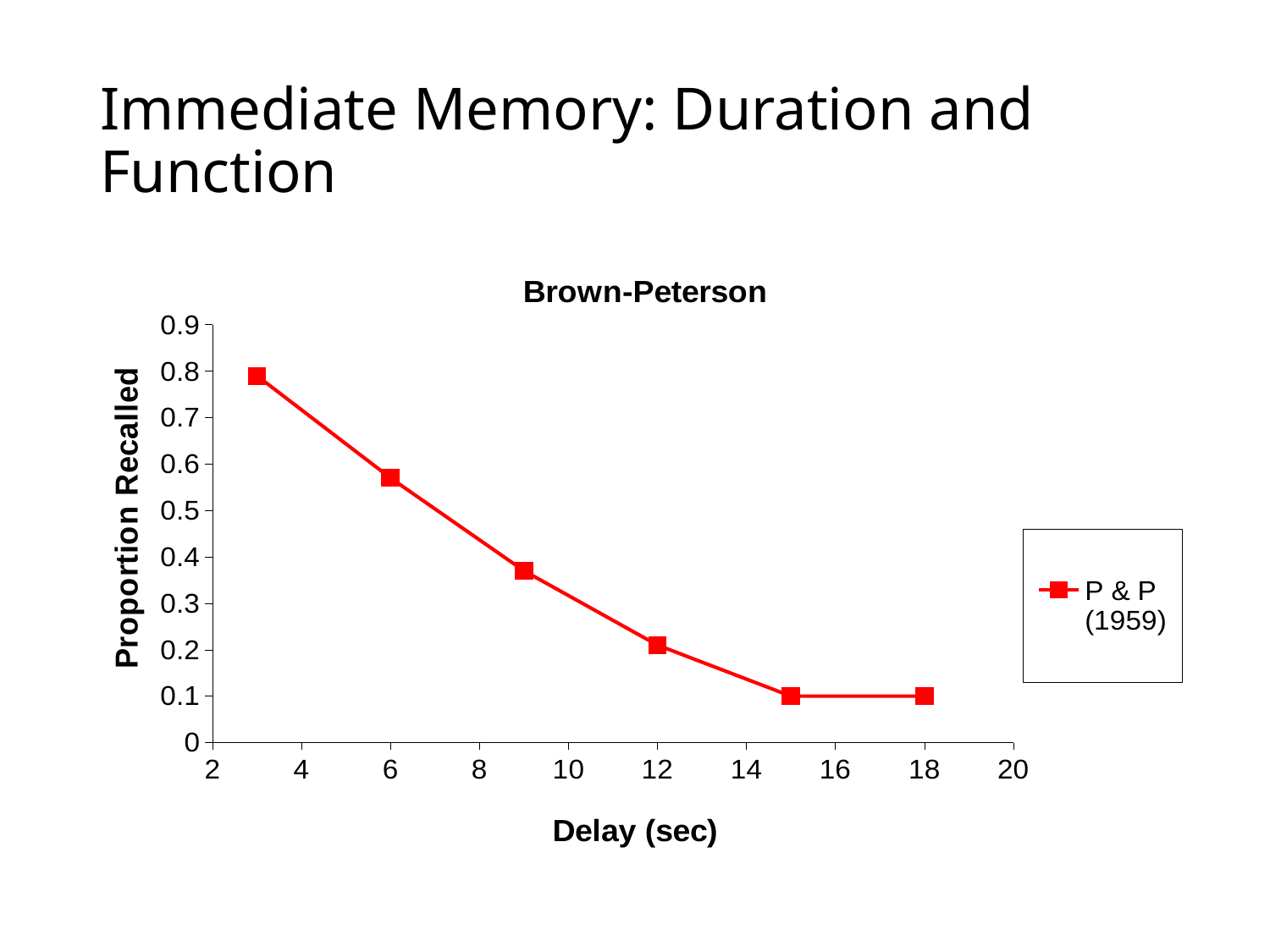
Is the proportion recalled at a delay of 9 sec greater or less than 0.4? less Does the proportion recalled rise or fall as delay increases along the x axis? fall Is the proportion recalled at a delay of 6 sec greater or less than 0.5? greater What is the title of the chart? Brown-Peterson What kind of chart is shown on the slide? line chart How many series does the legend list? 1 Is the proportion recalled at a delay of 3 sec greater or less than 0.7? greater What is the name of the series shown in the legend? P & P (1959) Which has a higher proportion recalled: a delay of 6 sec or a delay of 9 sec? 6 sec How many data points are plotted on the line? 6 At which delay is the proportion recalled highest? 3 sec